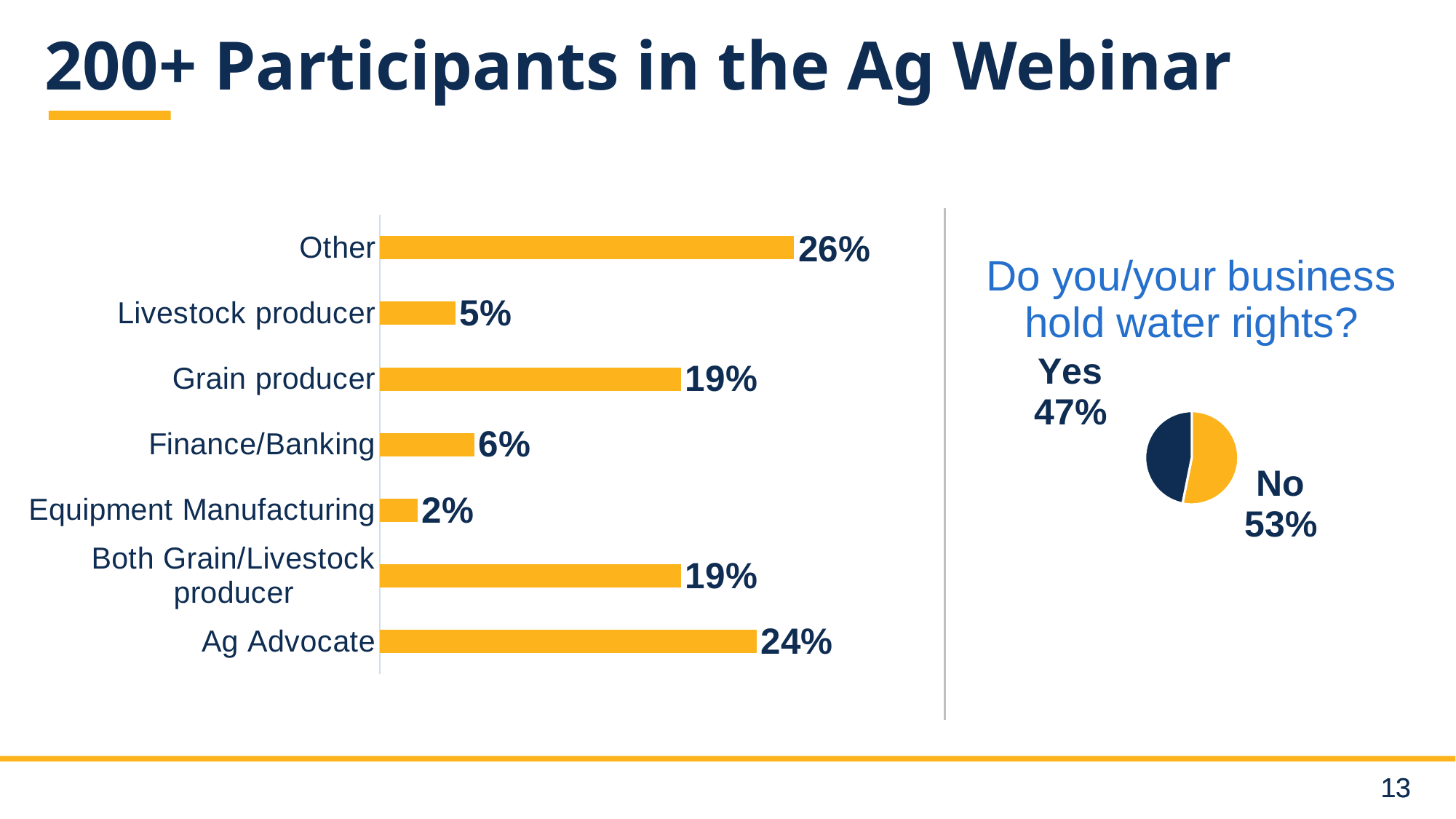
In the bar chart on the left, what is the value for Grain producer? 19% In the bar chart on the left, which is larger, Finance/Banking or Livestock producer? Finance/Banking In the bar chart on the left, what is the difference between Other and Ag Advocate? 2% In the bar chart on the left, which category has the highest value? Other In the bar chart on the left, what is the value for Equipment Manufacturing? 2% In the pie chart titled 'Do you/your business hold water rights?', what share answered No? 53% In the bar chart on the left, what is the value for Ag Advocate? 24% How many categories does the bar chart on the left show? 7 In the bar chart on the left, which category has the lowest value? Equipment Manufacturing What kind of chart is on the left side of the slide? Bar chart What kind of chart is on the right side of the slide? Pie chart In the pie chart titled 'Do you/your business hold water rights?', which answer has the larger share? No